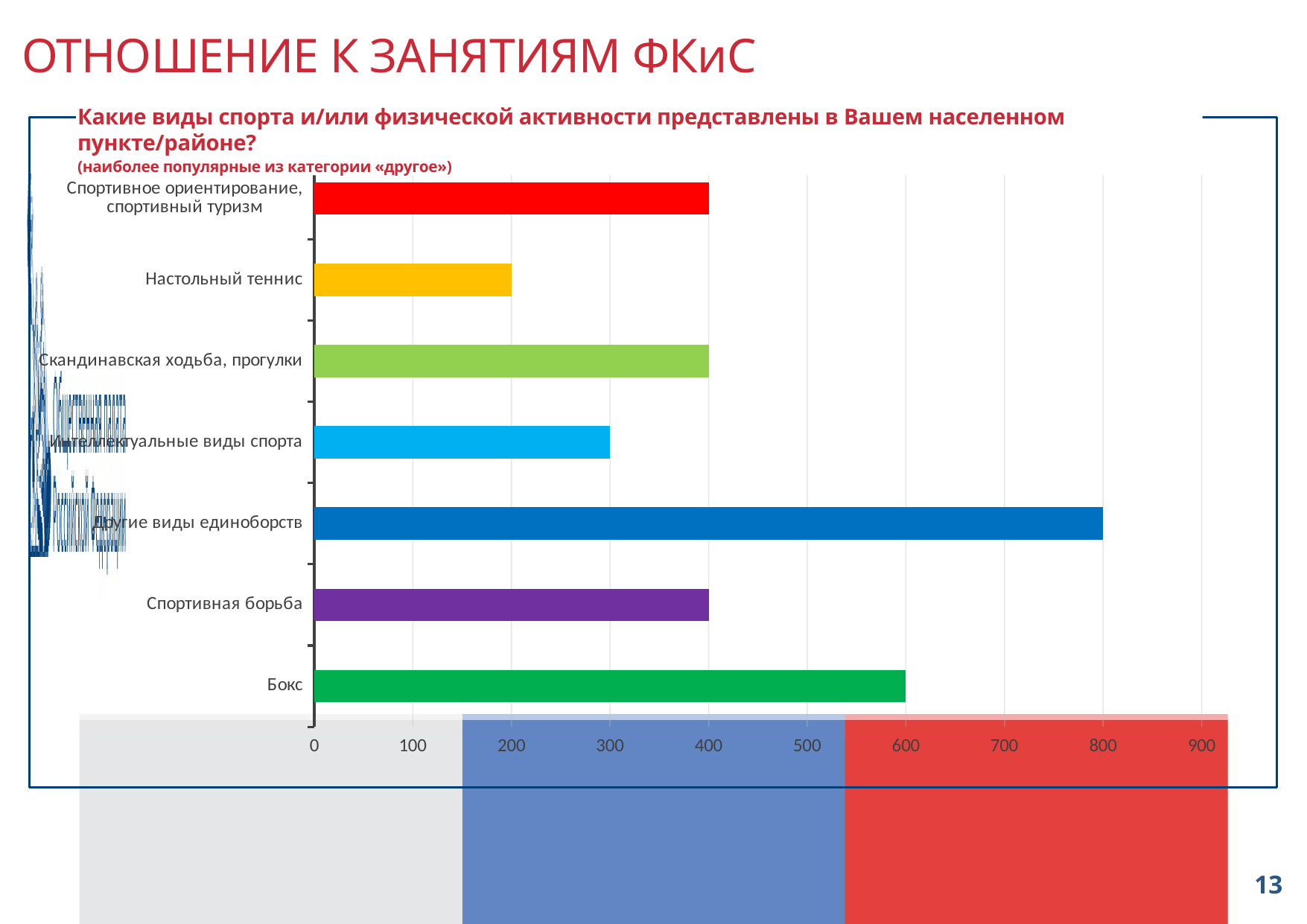
What is the value for Настольный теннис? 200 What is the value for Другие виды единоборств? 800 Which is larger, the value for Бокс or the value for Спортивная борьба? Бокс Which category has the lowest value in the chart? Настольный теннис Is the value for Скандинавская ходьба, прогулки greater or less than 500? less What is the value for Интеллектуальные виды спорта? 300 What colour is the bar for Бокс? green What is the value for Бокс? 600 What is the difference between the values for Другие виды единоборств and Бокс? 200 What kind of chart is shown on the slide? bar chart Which category has the highest value in the chart? Другие виды единоборств How many categories are plotted in the chart? 7